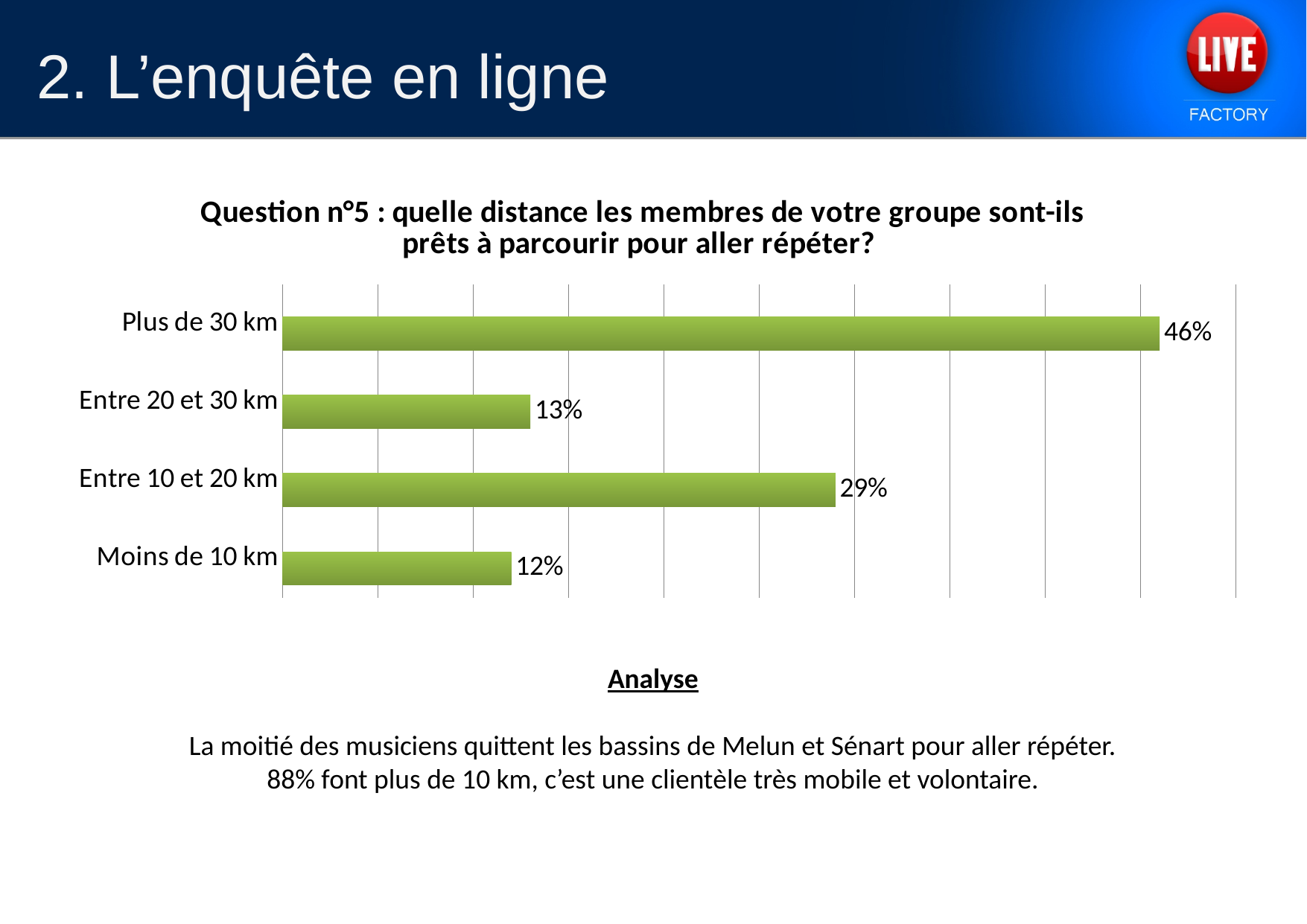
What percentage is shown for "Entre 10 et 20 km"? 29% Which category has the highest value? Plus de 30 km How many categories are shown in the chart? 4 What is the difference between the values for "Plus de 30 km" and "Entre 10 et 20 km"? 17% Which category has the lowest value? Moins de 10 km Which is larger, the value for "Entre 10 et 20 km" or the value for "Entre 20 et 30 km"? Entre 10 et 20 km What is the difference between the values for "Entre 20 et 30 km" and "Moins de 10 km"? 1% What colour are the bars in the chart? Green What percentage is shown for "Moins de 10 km"? 12% What kind of chart is shown on the slide? Bar chart What percentage is shown for "Plus de 30 km"? 46% What percentage is shown for "Entre 20 et 30 km"? 13%